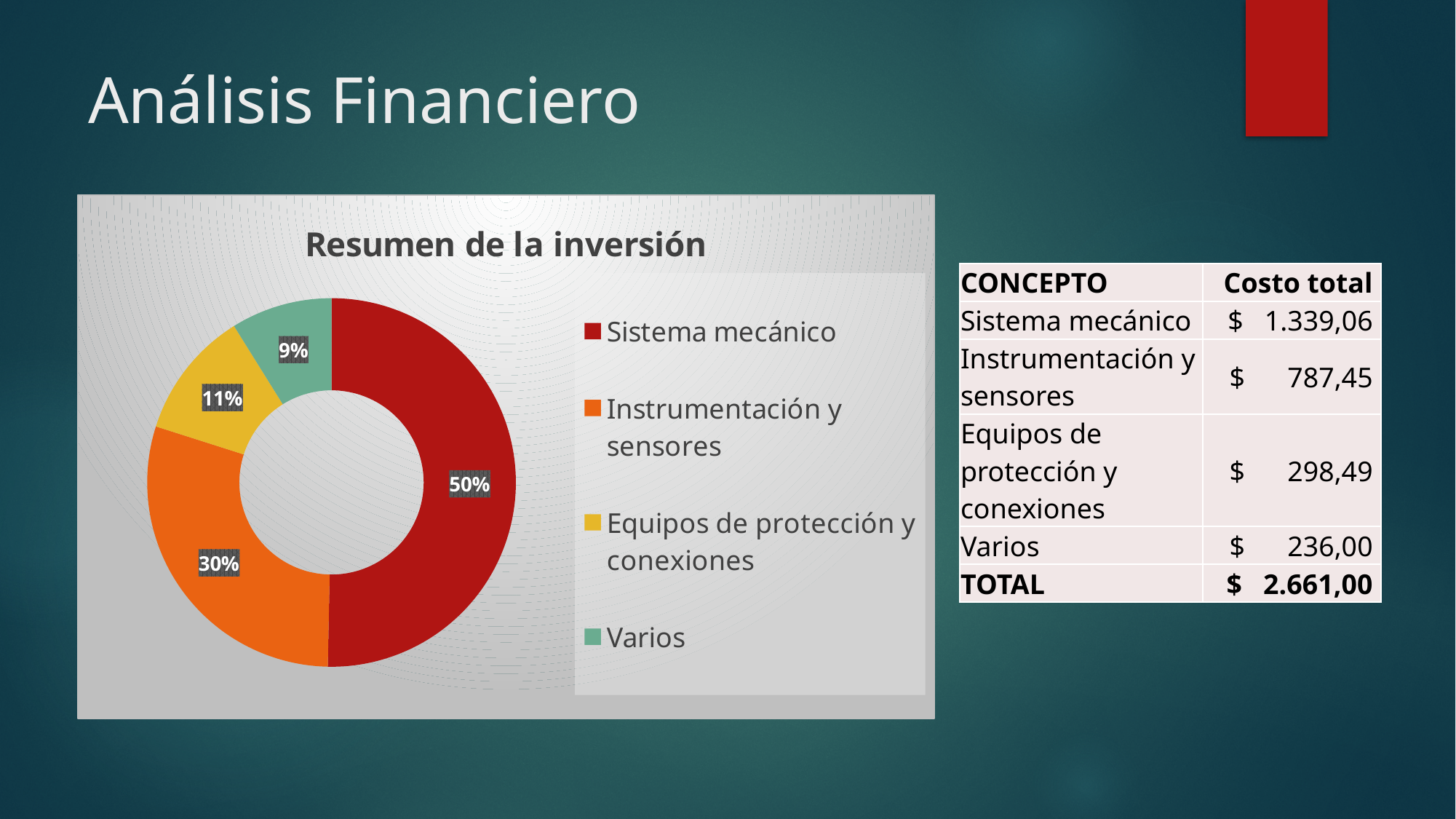
What is the difference in percentage points between "Sistema mecánico" and "Instrumentación y sensores"? 20 What percentage share does "Equipos de protección y conexiones" have in the chart? 11% What colour represents "Instrumentación y sensores" in the chart? Orange What kind of chart is shown under the title "Resumen de la inversión"? Doughnut (pie) chart What percentage share does "Sistema mecánico" have in the chart? 50% Which has a larger share, "Equipos de protección y conexiones" or "Varios"? Equipos de protección y conexiones Which category has the smallest share of the chart? Varios What is the title of the chart? Resumen de la inversión What percentage share does "Varios" have in the chart? 9% What percentage share does "Instrumentación y sensores" have in the chart? 30% Which category has the largest share of the chart? Sistema mecánico How many categories does the chart show? 4